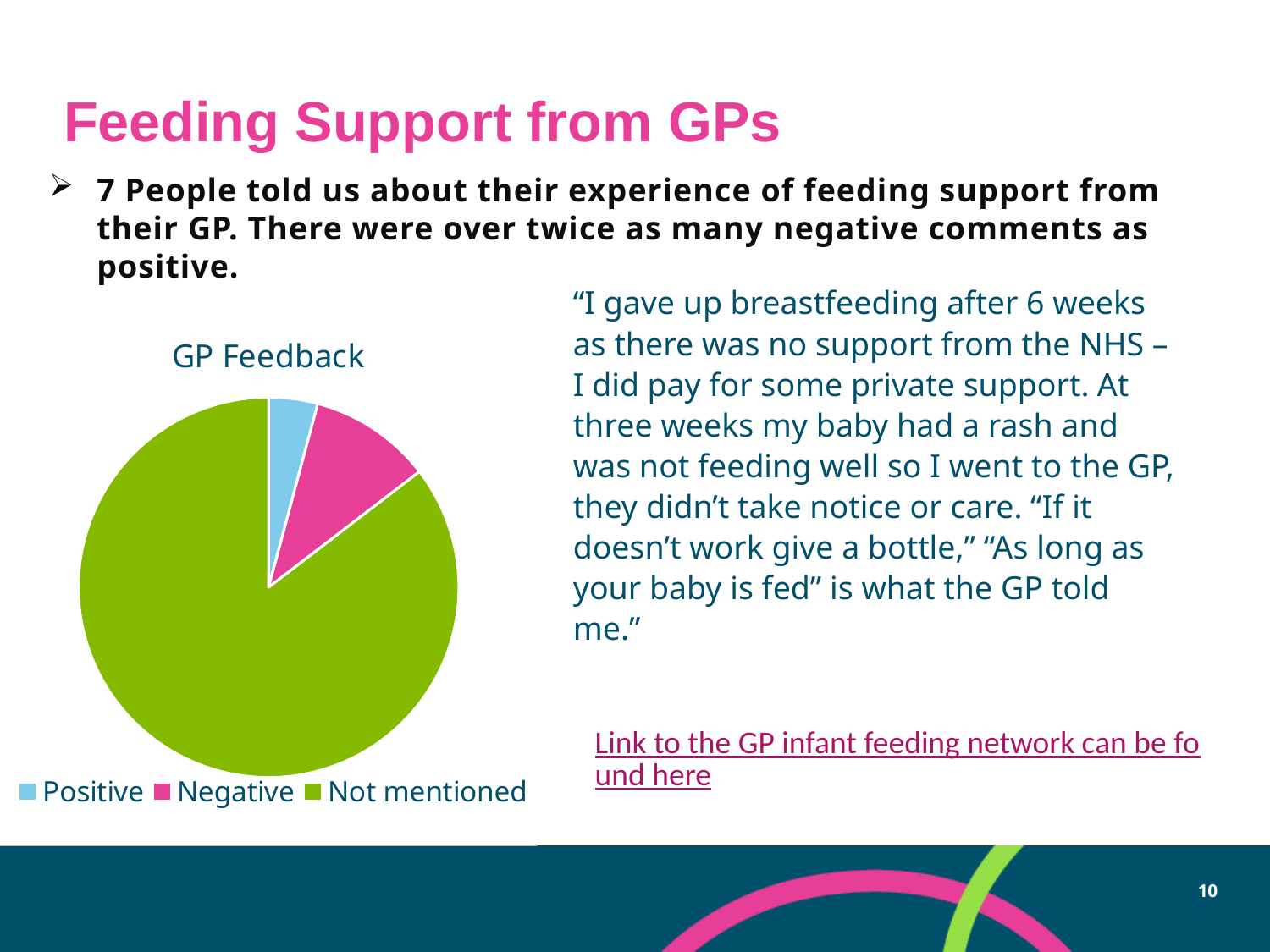
How many entries does the legend list? 3 Which category has the largest slice of the pie? Not mentioned Which category has the smallest slice of the pie? Positive Does the Not mentioned slice take up more or less than half of the pie? More Which colour represents the Negative category in the pie chart? Pink Which slice is larger, Negative or Positive? Negative What kind of chart is shown on the slide? Pie chart How many categories does the pie chart have? 3 What is the title of the chart? GP Feedback Which slice is larger, Not mentioned or Negative? Not mentioned